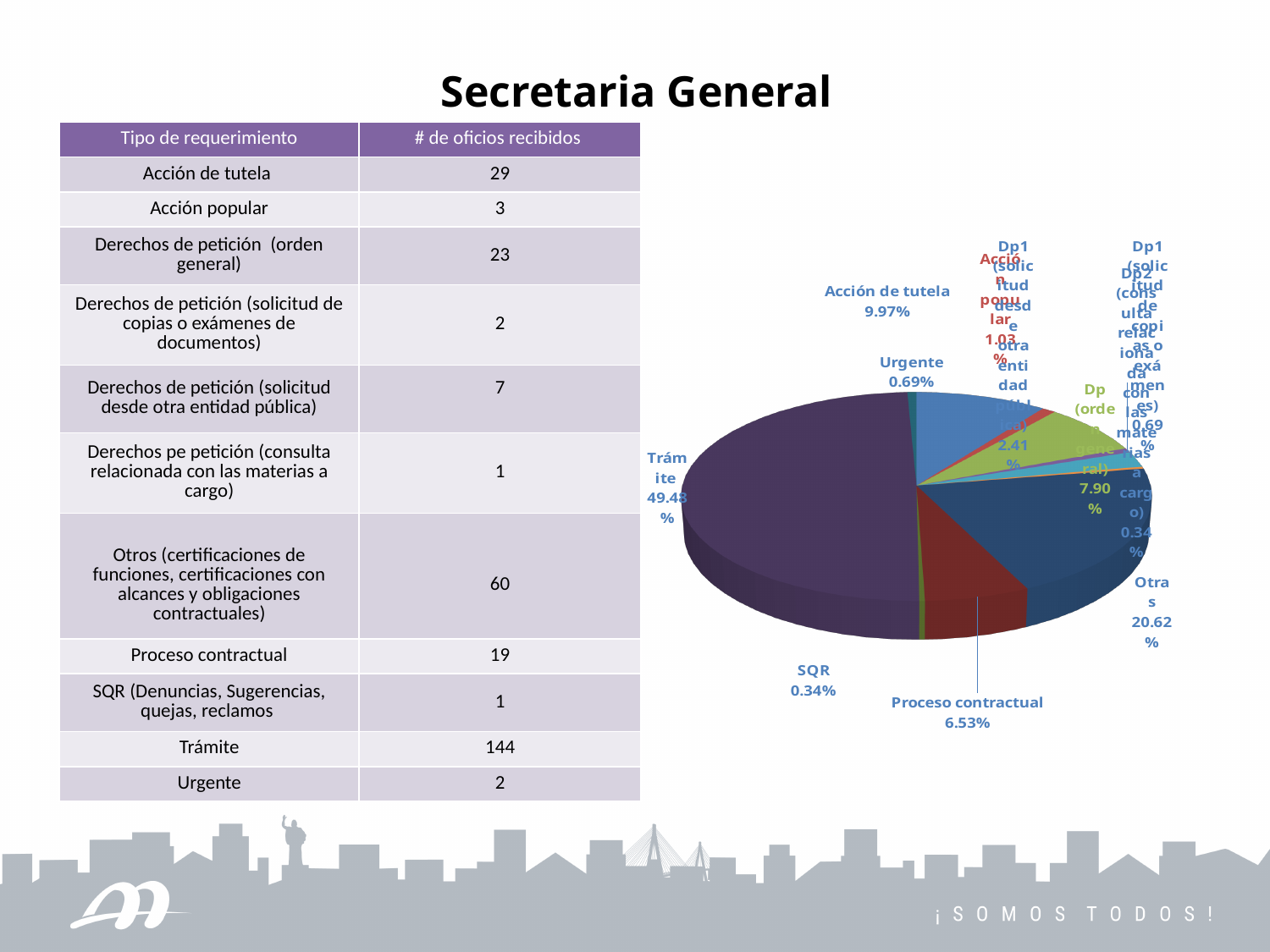
In the pie chart, what share is labelled for Urgente? 0.69% In the pie chart, what share is labelled for Otras? 20.62% Which slice is larger in the pie chart, Otras or Acción de tutela? Otras Which category has the largest slice in the pie chart? Trámite What kind of chart is shown on the slide? pie chart In the pie chart, what share is labelled for SQR? 0.34% How many categories (slices) does the pie chart represent? 11 In the pie chart, what share is labelled for Trámite? 49.48% In the pie chart, what share is labelled for Acción de tutela? 9.97% What is the difference in percentage points between the Trámite slice and the Otras slice in the pie chart? 28.86 Which slice is larger in the pie chart, Proceso contractual or Urgente? Proceso contractual In the pie chart, what share is labelled for Proceso contractual? 6.53%